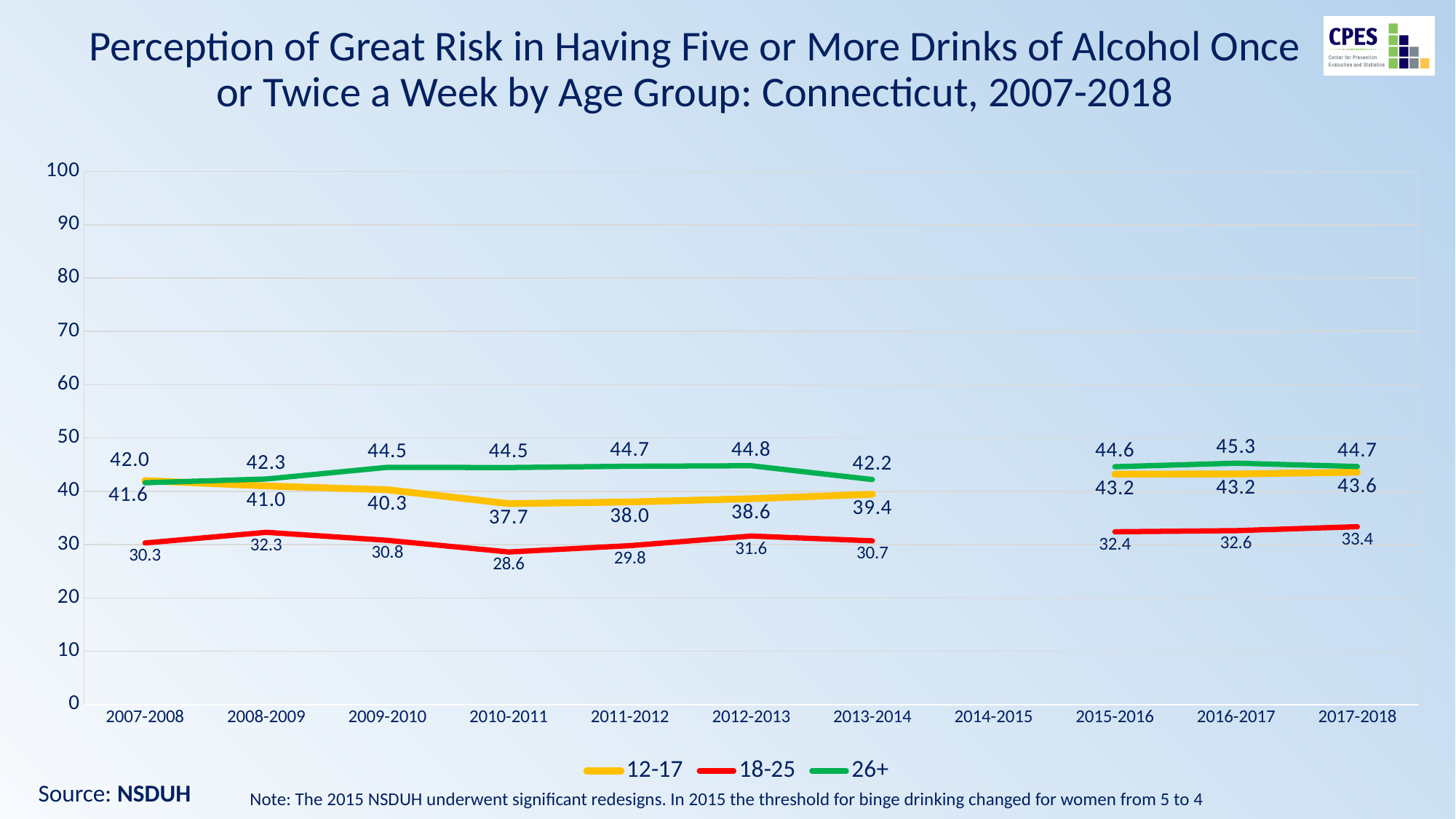
What type of chart is shown on the slide? line chart Is the value for the 18-25 age group in 2017-2018 greater or less than 40? less In which period does the 26+ series reach its highest value? 2016-2017 Which period on the x axis has no data plotted? 2014-2015 In which period does the 18-25 series reach its lowest value? 2010-2011 What is the difference between the 26+ value and the 18-25 value in 2012-2013? 13.2 How many series does the legend list? 3 What is the value for the 12-17 age group in 2013-2014? 39.4 Does the 12-17 series rise or fall from 2007-2008 to 2010-2011? fall Which is larger in 2015-2016: the value for 12-17 or the value for 18-25? 12-17 What is the value for the 26+ age group in 2016-2017? 45.3 What is the value for the 18-25 age group in 2010-2011? 28.6